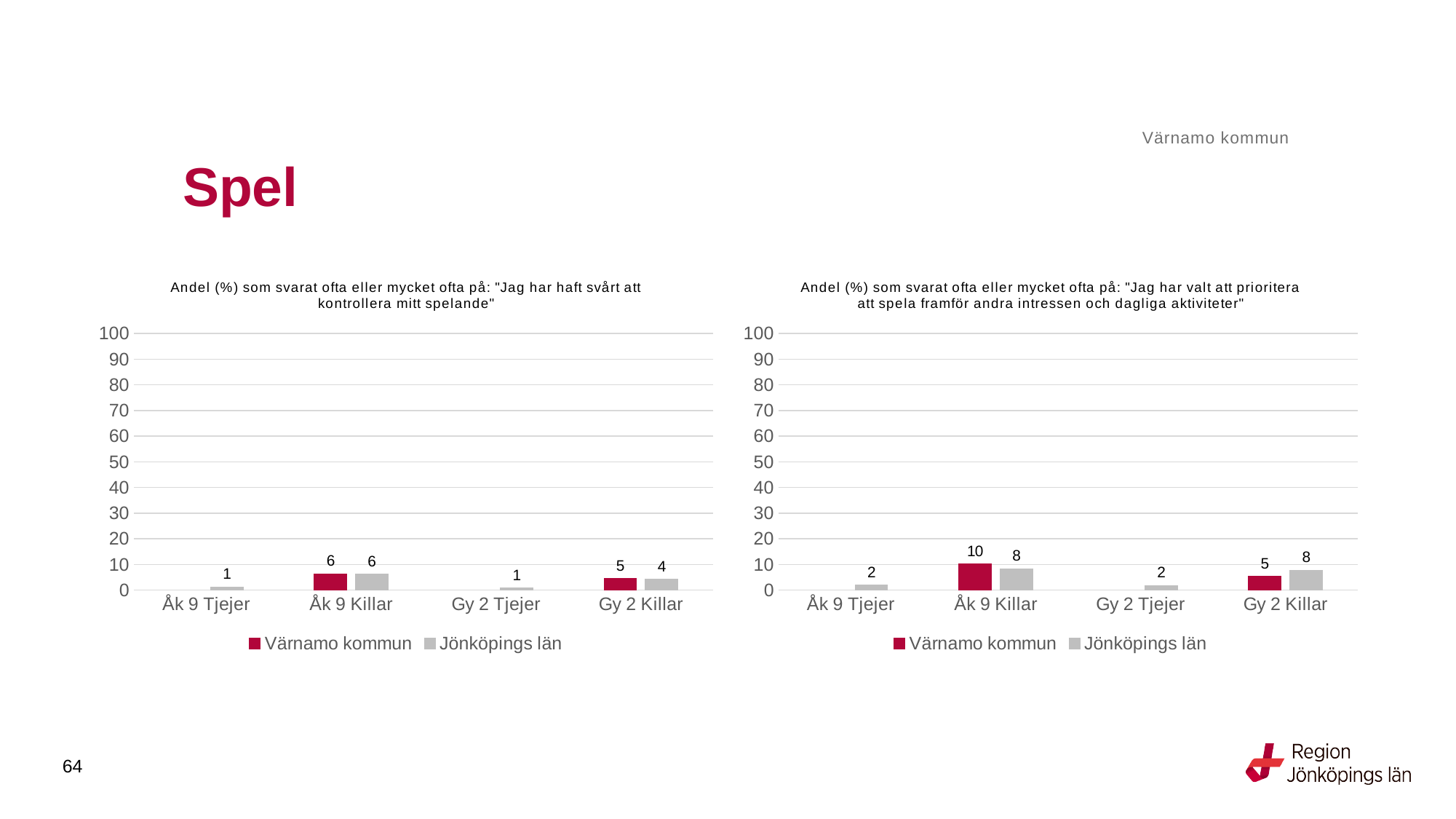
In the left chart ("Jag har haft svårt att kontrollera mitt spelande"), what is the value for Värnamo kommun for Åk 9 Killar? 6 In the right chart ("Jag har valt att prioritera att spela framför andra intressen..."), what is the value for Värnamo kommun for Åk 9 Killar? 10 In the left chart ("Jag har haft svårt att kontrollera mitt spelande"), what is the value for Jönköpings län for Gy 2 Killar? 4 In the left chart ("Jag har haft svårt att kontrollera mitt spelande"), what is the value for Jönköpings län for Gy 2 Tjejer? 1 How many categories are shown on the x axis of the left chart? 4 In the right chart ("Jag har valt att prioritera att spela framför andra intressen..."), what is the value for Jönköpings län for Gy 2 Killar? 8 In the right chart ("Jag har valt att prioritera att spela framför andra intressen..."), is the value for Värnamo kommun for Åk 9 Killar greater or less than 20? less In the left chart ("Jag har haft svårt att kontrollera mitt spelande"), what is the difference between Värnamo kommun and Jönköpings län for Gy 2 Killar? 1 In the right chart ("Jag har valt att prioritera att spela framför andra intressen..."), which category has the highest value for Jönköpings län? Åk 9 Killar and Gy 2 Killar (both 8) In the right chart ("Jag har valt att prioritera att spela framför andra intressen..."), what is the difference between Värnamo kommun and Jönköpings län for Åk 9 Killar? 2 How many series does the legend of the right chart list? 2 In the right chart ("Jag har valt att prioritera att spela framför andra intressen..."), which is larger for Gy 2 Killar: Värnamo kommun or Jönköpings län? Jönköpings län